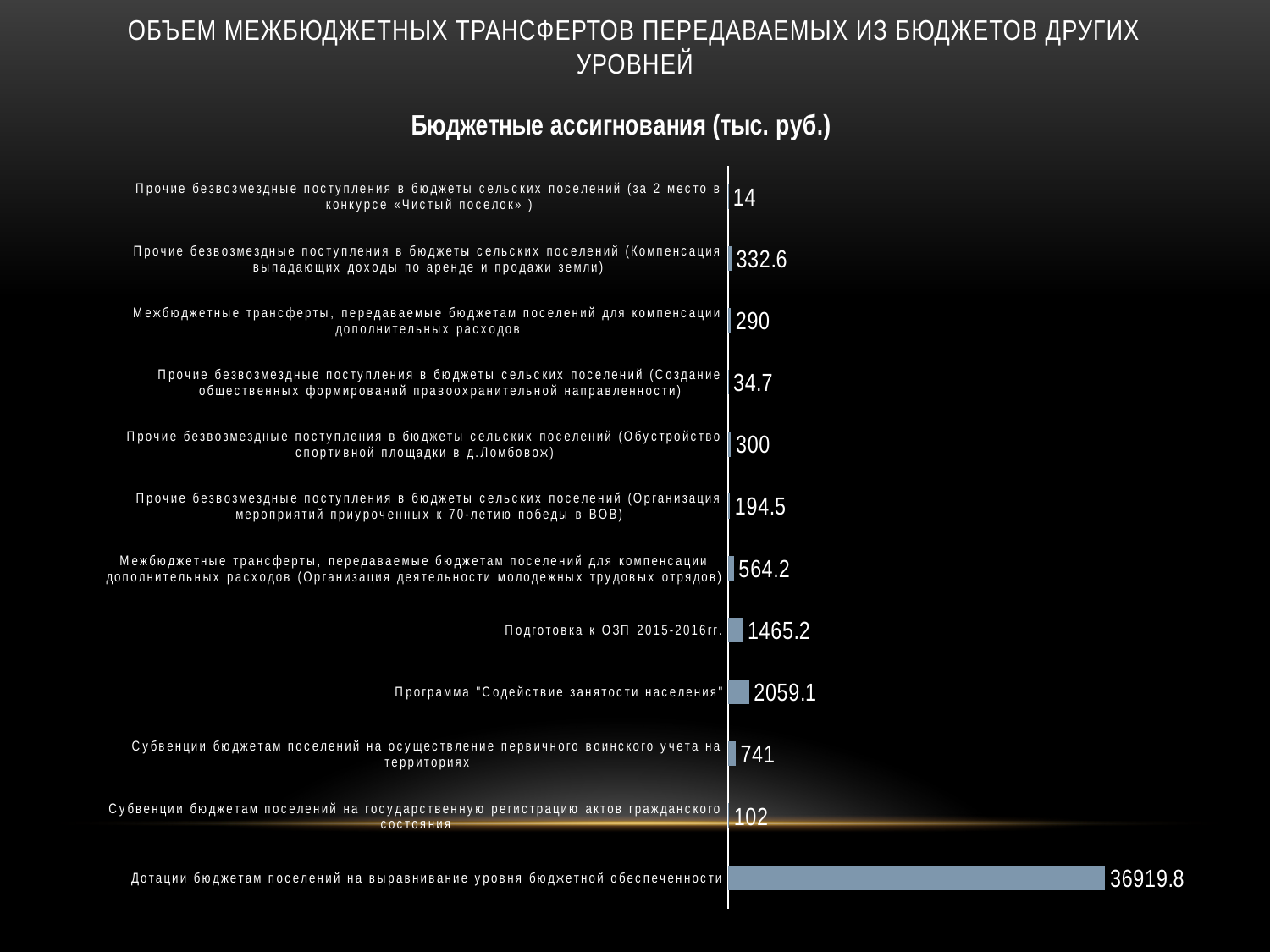
Which category has the lowest value? Прочие безвозмездные поступления в бюджеты сельских поселений (за 2 место в конкурсе «Чистый поселок») What type of chart is shown on the slide? bar chart Which is larger: the value for "Субвенции бюджетам поселений на осуществление первичного воинского учета на территориях" or the value for "Субвенции бюджетам поселений на государственную регистрацию актов гражданского состояния"? Субвенции бюджетам поселений на осуществление первичного воинского учета на территориях What is the value for "Программа "Содействие занятости населения""? 2059.1 What is the difference between the values for "Субвенции бюджетам поселений на осуществление первичного воинского учета на территориях" and "Субвенции бюджетам поселений на государственную регистрацию актов гражданского состояния"? 639 What is the value for "Субвенции бюджетам поселений на осуществление первичного воинского учета на территориях"? 741 How many categories are plotted in the chart? 12 What is the difference between the values for "Программа "Содействие занятости населения"" and "Подготовка к ОЗП 2015-2016гг."? 593.9 What is the value for "Дотации бюджетам поселений на выравнивание уровня бюджетной обеспеченности"? 36919.8 Which category has the highest value? Дотации бюджетам поселений на выравнивание уровня бюджетной обеспеченности What is the title of the chart? Бюджетные ассигнования (тыс. руб.) What is the value for "Подготовка к ОЗП 2015-2016гг."? 1465.2